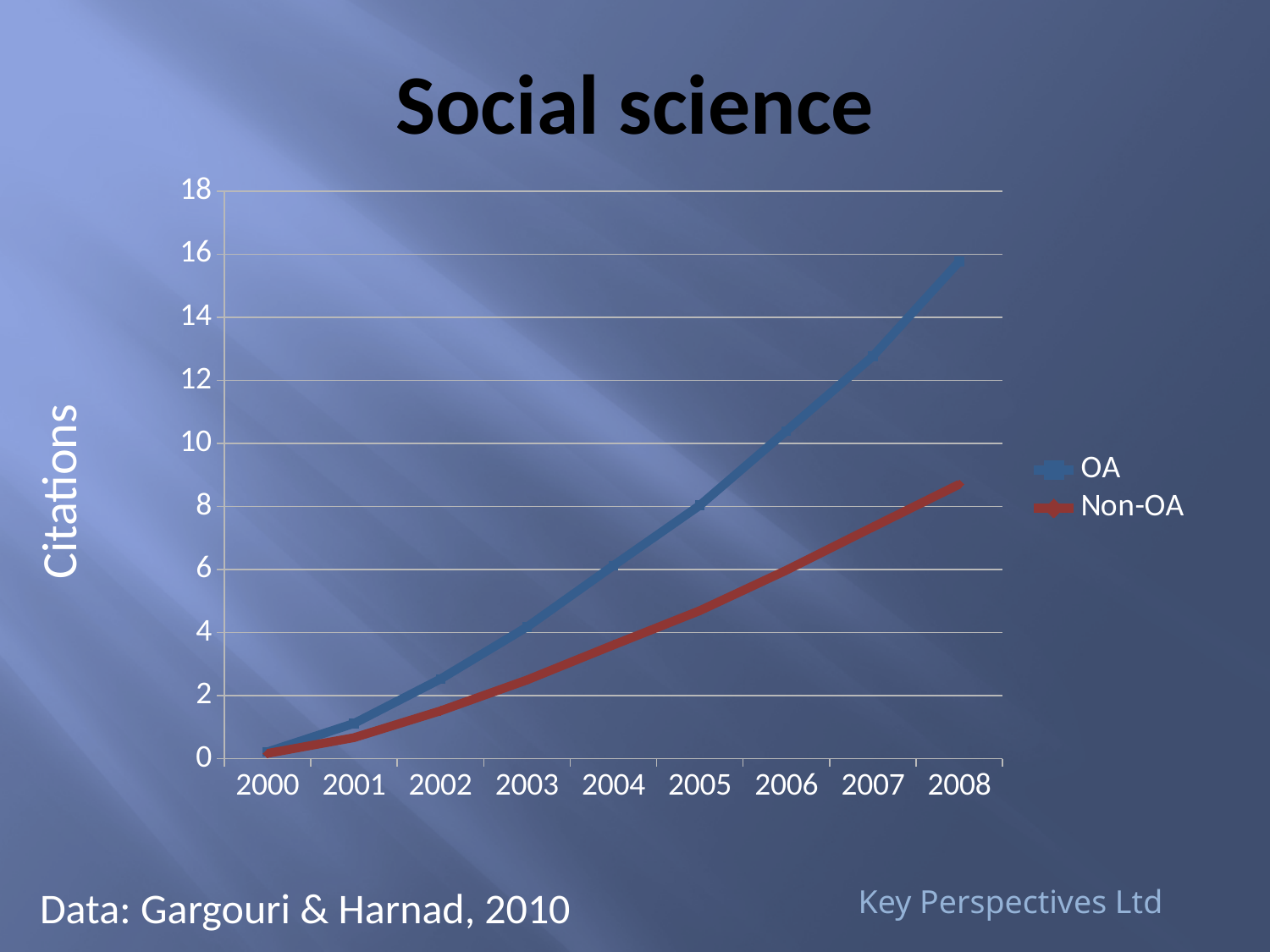
What kind of chart is shown on the slide? line chart How many years are shown along the x axis? 9 Is the Non-OA value for 2002 greater or less than 2? less Which series has the higher value in 2008, OA or Non-OA? OA Do the OA citations rise or fall from 2000 to 2008? rise Is the OA value for 2008 greater or less than 14? greater How many series does the legend list? 2 Is the Non-OA value for 2008 greater or less than 10? less What is the label on the y axis? Citations What is the title of the chart? Social science